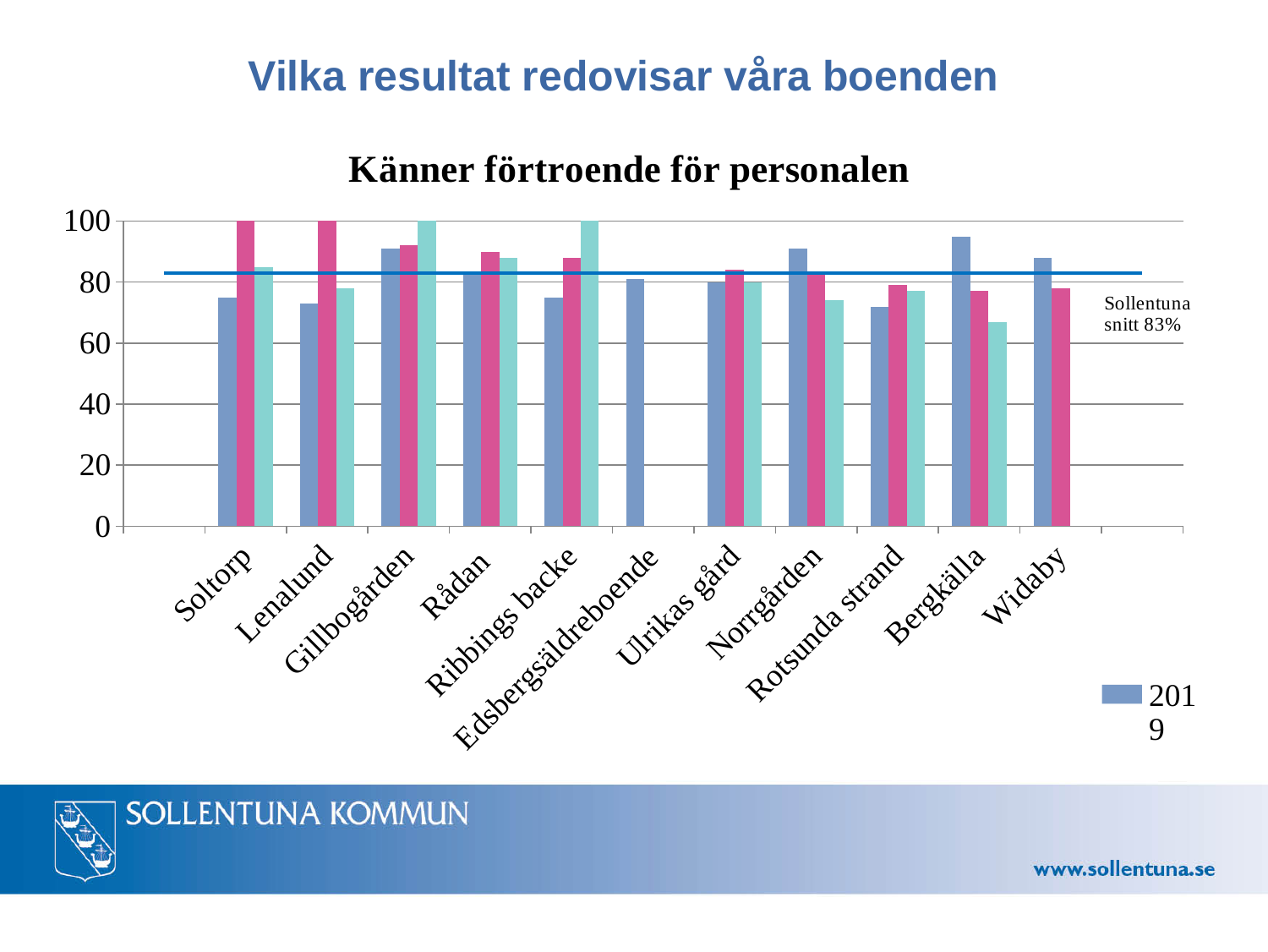
Which residence has the highest 2019 value? Bergkälla What kind of chart is shown on the slide? bar chart Is the 2019 value for Lenalund greater or less than 80? less Which has the larger 2019 value, Bergkälla or Soltorp? Bergkälla What is the title of the chart? Känner förtroende för personalen Is the 2019 value for Rotsunda strand greater or less than 80? less What value does the horizontal reference line labelled 'Sollentuna snitt' represent? 83% Is the 2019 value for Soltorp greater or less than 80? less Which has the larger 2019 value, Gillbogården or Lenalund? Gillbogården How many residences (categories) are shown on the x axis of the chart? 11